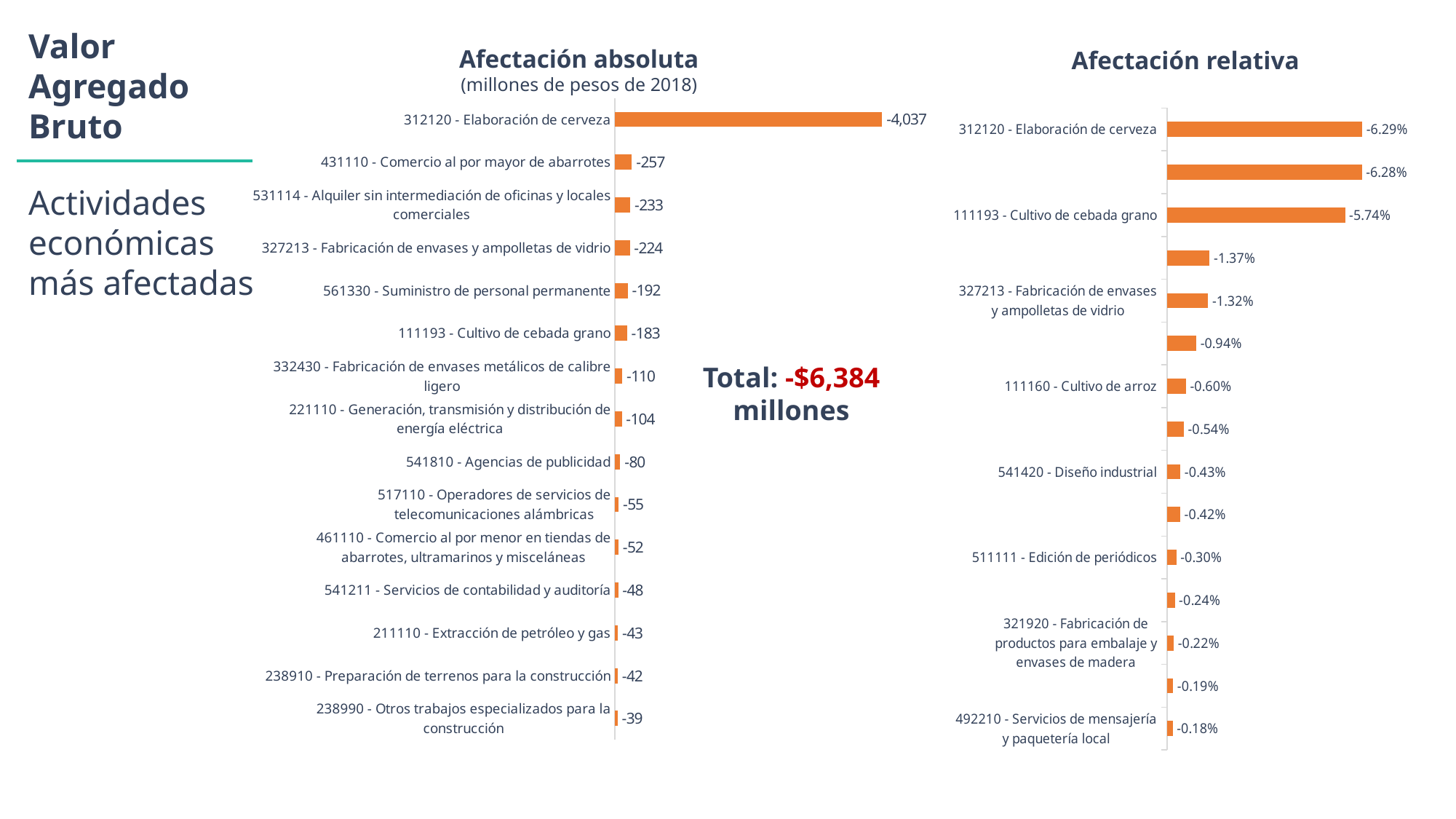
In the 'Afectación absoluta' chart, what is the value for 238990 - Otros trabajos especializados para la construcción? -39 In the 'Afectación absoluta' chart, which category has the shortest bar (smallest absolute affectation)? 238990 - Otros trabajos especializados para la construcción In the 'Afectación relativa' chart, which bar is longer: 327213 - Fabricación de envases y ampolletas de vidrio or 541420 - Diseño industrial? 327213 - Fabricación de envases y ampolletas de vidrio In the 'Afectación relativa' chart, what is the value for 111193 - Cultivo de cebada grano? -5.74% In the 'Afectación absoluta' chart, what is the value for 312120 - Elaboración de cerveza? -4,037 In the 'Afectación relativa' chart, what is the value for 111160 - Cultivo de arroz? -0.60% In the 'Afectación absoluta' chart, what is the difference between the values for 431110 - Comercio al por mayor de abarrotes and 111193 - Cultivo de cebada grano? 74 What total is printed between the two charts? -$6,384 millones In the 'Afectación absoluta' chart, what is the value for 561330 - Suministro de personal permanente? -192 What kind of chart is the 'Afectación relativa' chart? Bar chart How many categories are plotted in the 'Afectación absoluta' chart? 15 In the 'Afectación absoluta' chart, which category has the longest bar (largest absolute affectation)? 312120 - Elaboración de cerveza